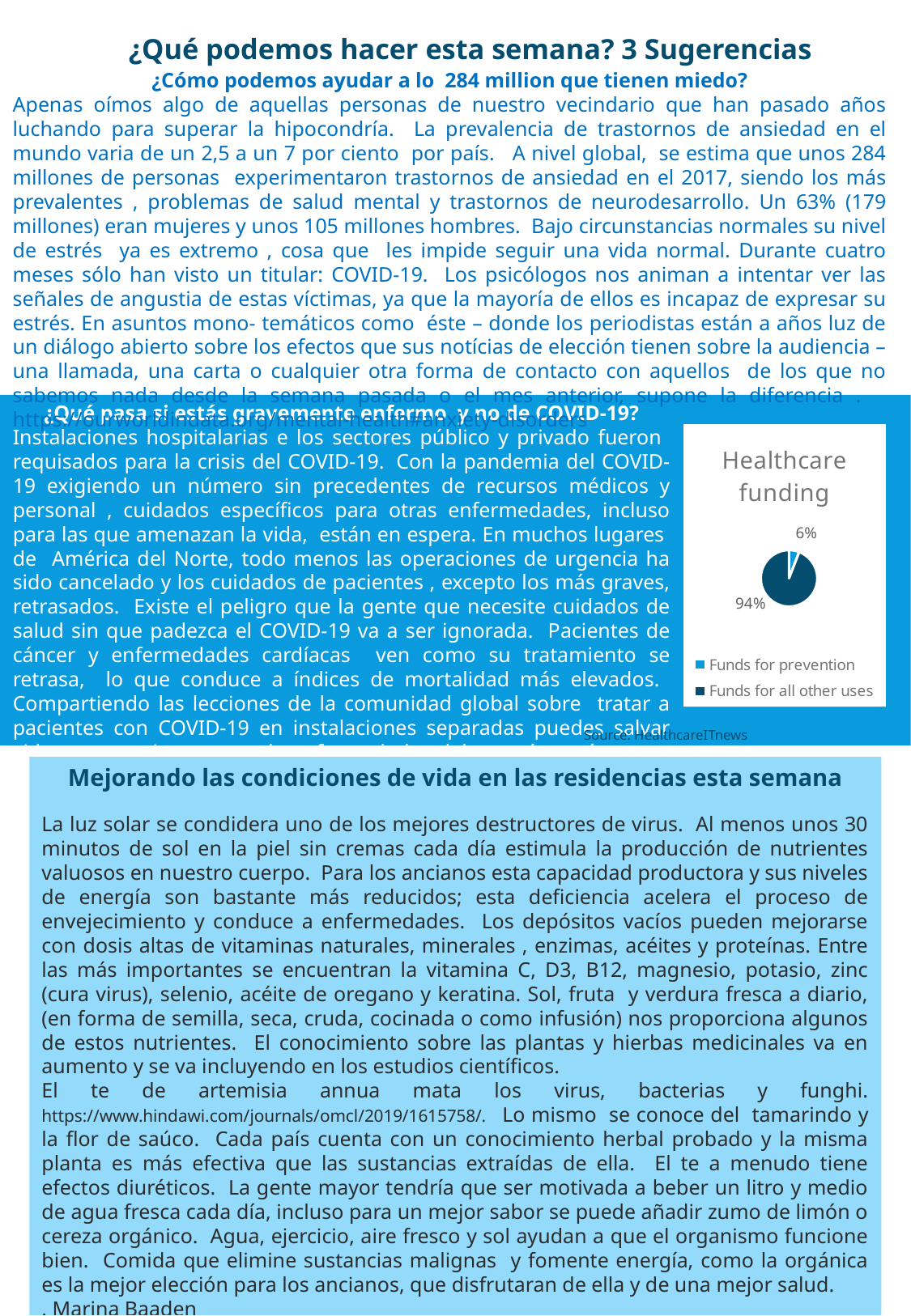
What is the title of the chart on the slide? Healthcare funding Which slice of the Healthcare funding pie is the smallest? Funds for prevention How many slices does the Healthcare funding pie chart have? 2 How many entries does the legend of the Healthcare funding chart list? 2 What share of healthcare funding goes to funds for prevention? 6% Which is larger in the Healthcare funding chart: funds for prevention or funds for all other uses? Funds for all other uses What share of healthcare funding goes to funds for all other uses? 94% Which slice of the Healthcare funding pie is the largest? Funds for all other uses What is the difference in percentage points between funds for all other uses and funds for prevention? 88 What source is cited below the Healthcare funding chart? HealthcareITnews What kind of chart is shown on the slide? pie chart